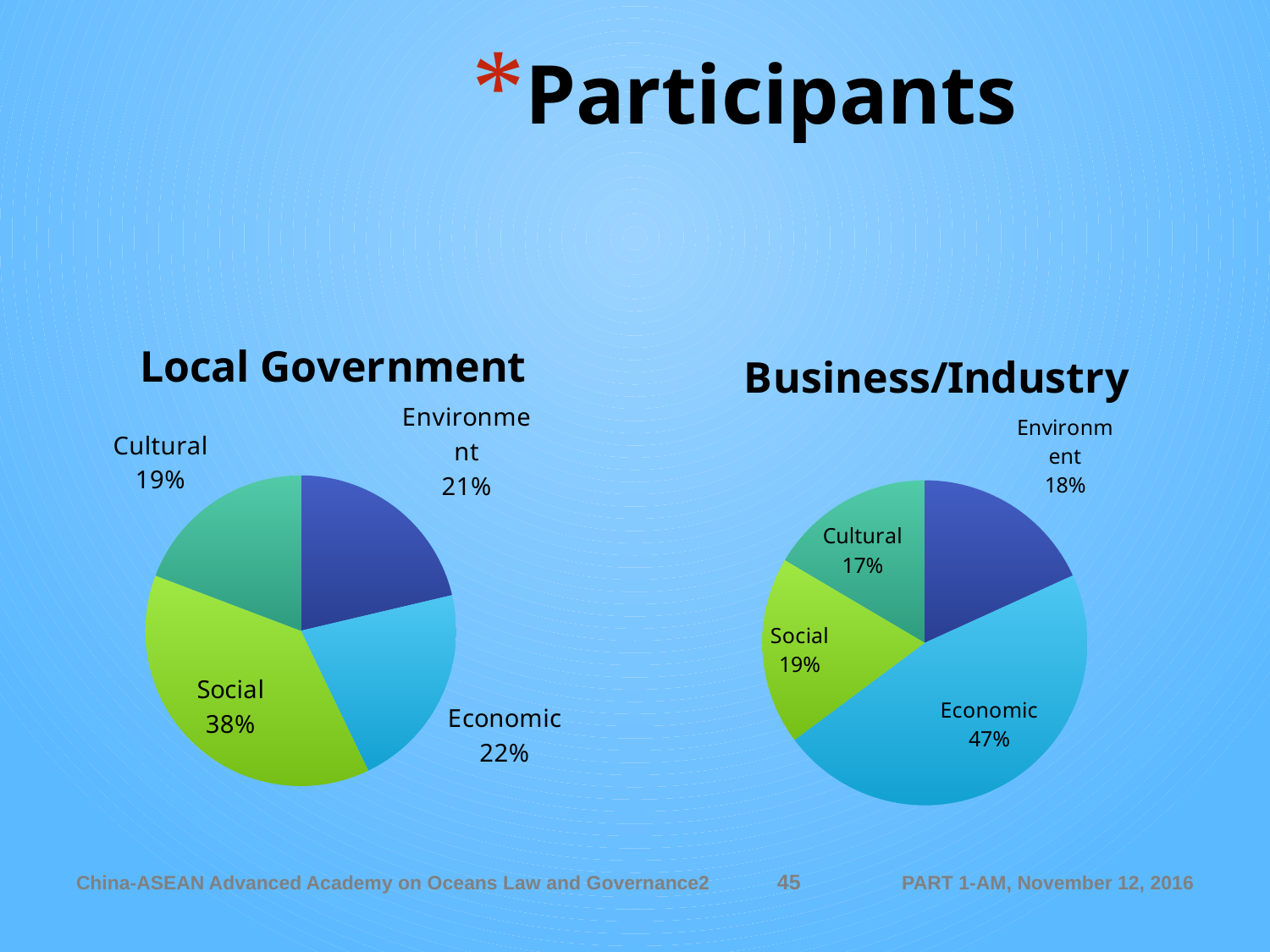
In the Local Government chart, which category has the largest slice? Social In the Local Government chart, what share does Social have? 38% In the Local Government chart, what is the difference between the Social and Cultural shares? 19% In the Business/Industry chart, what share does Cultural have? 17% In the Business/Industry chart, which category has the largest slice? Economic In the Local Government chart, which is larger, Economic or Cultural? Economic In the Business/Industry chart, what share does Economic have? 47% How many slices does the Business/Industry chart have? 4 In the Local Government chart, what share does Environment have? 21% What type of chart is the Local Government chart? Pie chart In the Business/Industry chart, what is the difference between the Economic and Social shares? 28% In the Business/Industry chart, which category has the smallest slice? Cultural